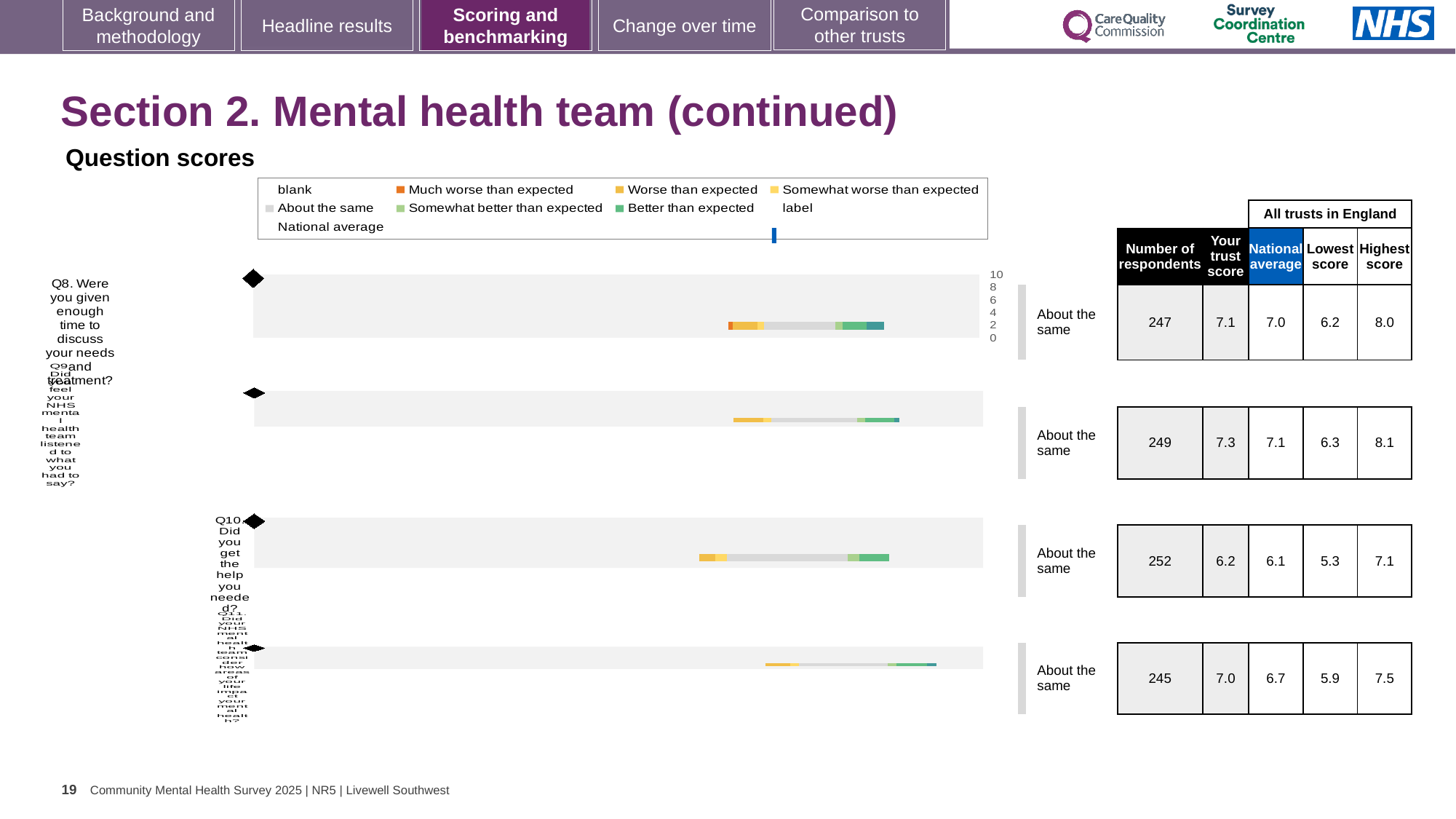
What kind of chart is used for the question scores on this slide? bar chart In the legend, which colour represents 'Better than expected'? green In the table beside the Q11 chart, what is the highest score among all trusts in England? 7.5 How many question-score charts (Q8 to Q11) are shown on the slide? 4 For Q8, what is the difference between the highest score (8.0) and the lowest score (6.2) in the table? 1.8 Which question (Q8 to Q11) has the lowest 'Your trust score' in the tables? Q10 Which question (Q8 to Q11) has the highest 'Your trust score' in the tables? Q9 In the table beside the Q8 chart, what is the number of respondents? 247 In the table beside the Q9 chart, what is 'Your trust score'? 7.3 In the table beside the Q10 chart, what is the national average? 6.1 For Q9, which is larger: 'Your trust score' or the national average? Your trust score In the legend, which colour represents 'Much worse than expected'? orange